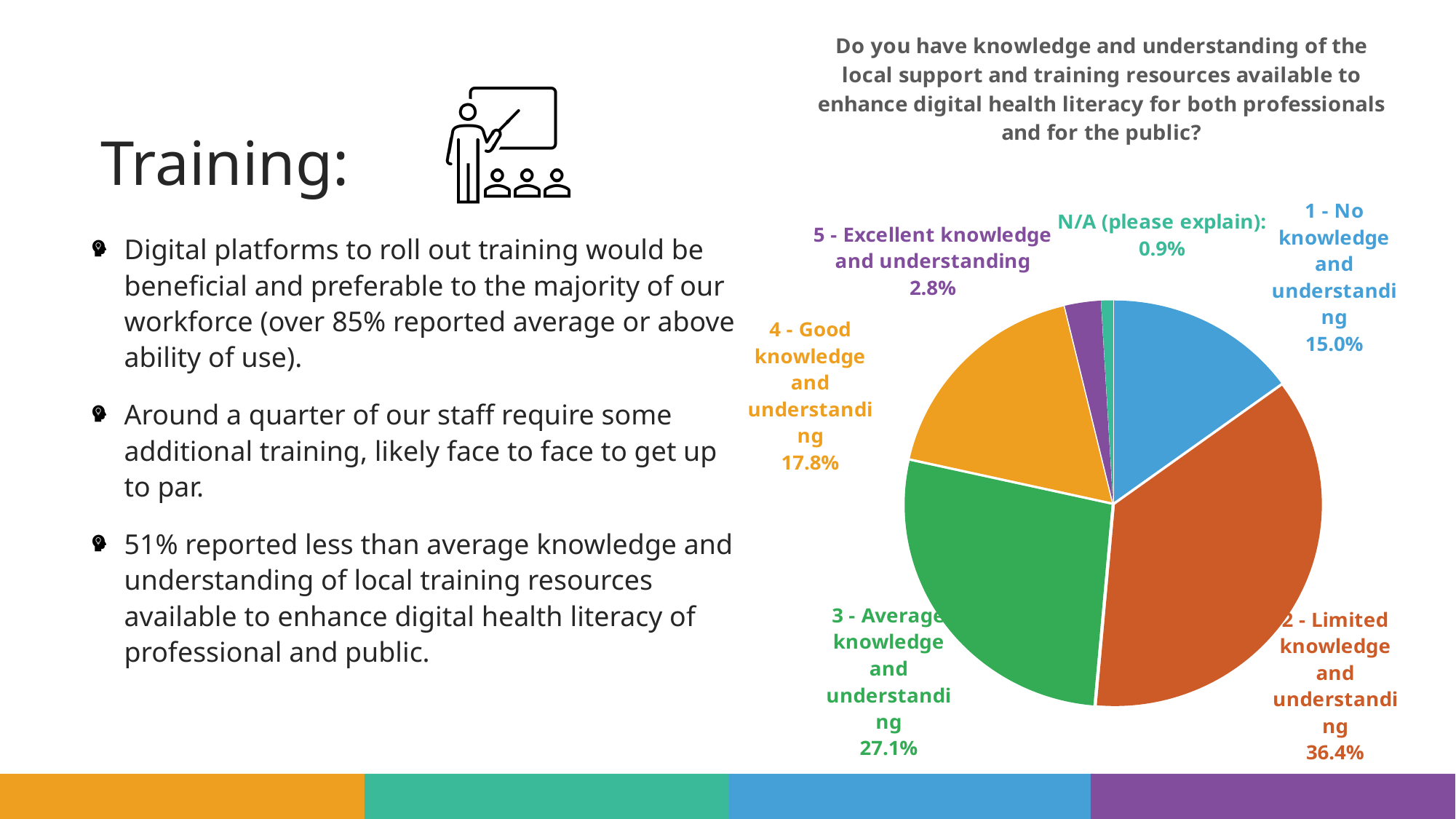
What is the combined percentage of '1 - No knowledge and understanding' and '2 - Limited knowledge and understanding'? 51.4% What colour is the slice for '5 - Excellent knowledge and understanding'? purple Which is larger: the share for '4 - Good knowledge and understanding' or '1 - No knowledge and understanding'? 4 - Good knowledge and understanding Which category has the largest share of the pie? 2 - Limited knowledge and understanding What is the difference in percentage points between '3 - Average knowledge and understanding' and '1 - No knowledge and understanding'? 12.1 What percentage of respondents answered 'N/A (please explain)'? 0.9% What percentage of respondents reported '2 - Limited knowledge and understanding'? 36.4% What percentage of respondents reported '4 - Good knowledge and understanding'? 17.8% What kind of chart is shown on the slide? pie chart How many categories are shown in the pie chart? 6 What question does the chart title ask? Do you have knowledge and understanding of the local support and training resources available to enhance digital health literacy for both professionals and for the public? Which category has the smallest share of the pie? N/A (please explain)